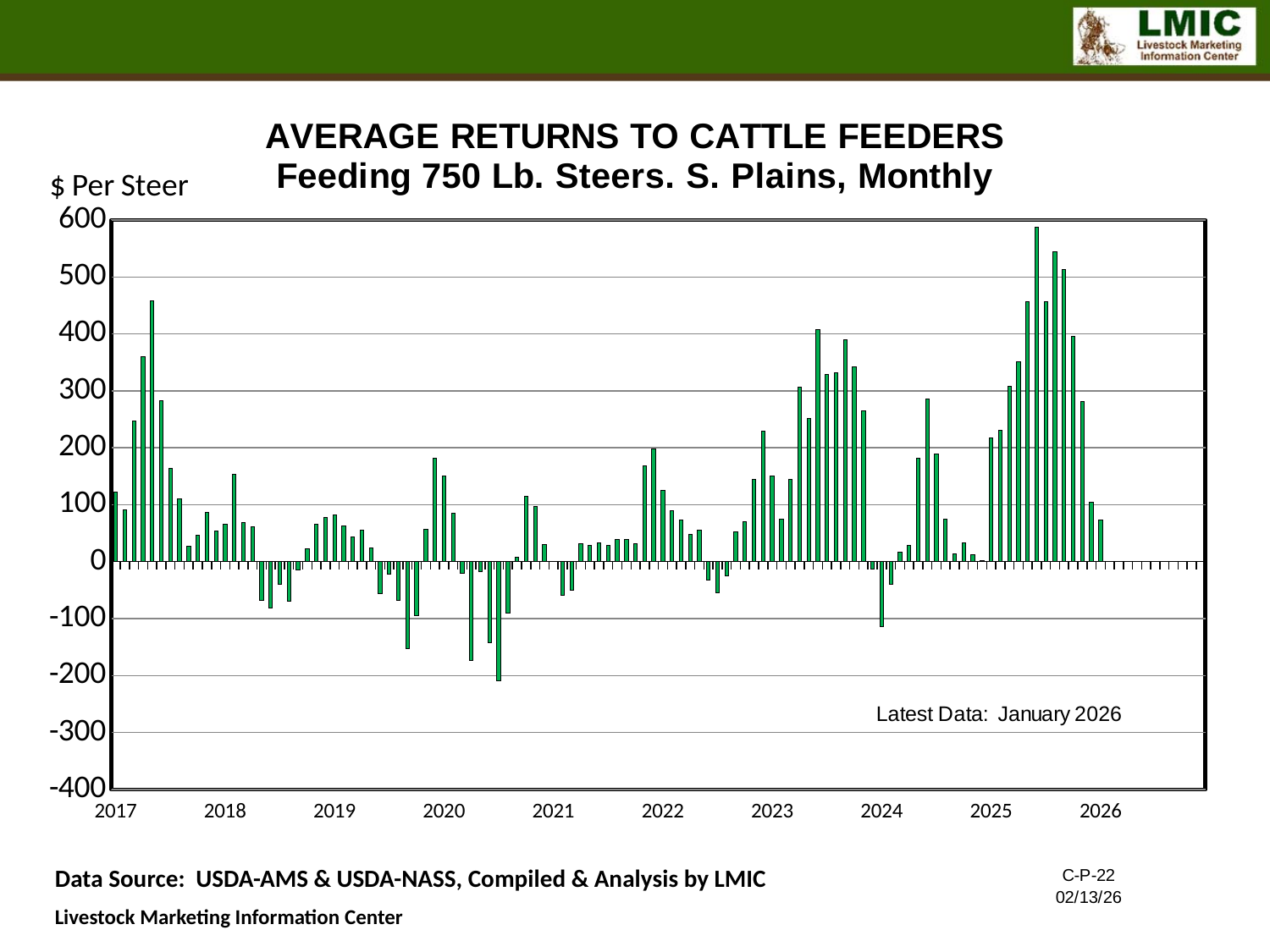
What unit is shown on the vertical axis of the chart? $ Per Steer What is the title of the chart? AVERAGE RETURNS TO CATTLE FEEDERS Feeding 750 Lb. Steers. S. Plains, Monthly Is the lowest bar in 2020 greater or less than -100? less Which is larger: the tallest bar in 2025 or the tallest bar in 2017? The tallest bar in 2025 In which year does the tallest bar on the chart occur? 2025 In which year does the lowest (most negative) bar on the chart occur? 2020 What kind of chart is shown on the slide? Bar chart Do the bars generally rise or fall from the peak in 2017 through the end of 2018? Fall Is the tallest bar in 2017 greater or less than 400? greater Is the lowest bar in 2018 greater or less than -100? greater Which is larger: the tallest bar in 2023 or the tallest bar in 2022? The tallest bar in 2023